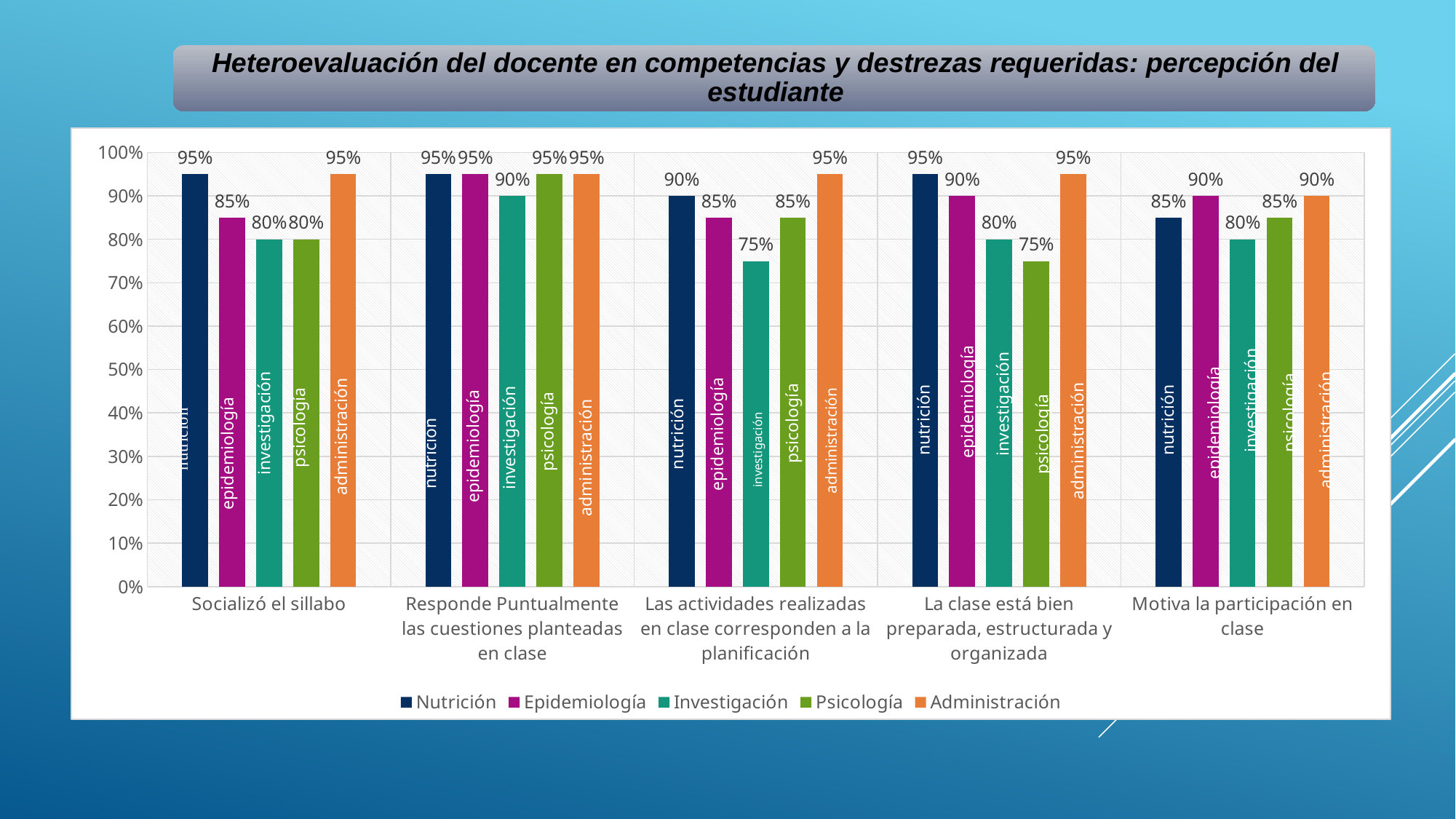
What is the value for Nutrición in the 'Socializó el sillabo' category? 95% What kind of chart is shown on the slide? Bar chart What is the value for Administración in the 'Motiva la participación en clase' category? 90% What is the value for Investigación in the 'Las actividades realizadas en clase corresponden a la planificación' category? 75% What is the difference between Nutrición and Psicología in the 'La clase está bien preparada, estructurada y organizada' category? 20% Which series has the highest value in the 'Las actividades realizadas en clase corresponden a la planificación' category? Administración Which series has the lowest value in the 'Socializó el sillabo' category? Investigación and Psicología (80%) What is the value for Psicología in the 'La clase está bien preparada, estructurada y organizada' category? 75% In the 'Motiva la participación en clase' category, which is larger: Epidemiología or Nutrición? Epidemiología Which series is shown in orange in the legend? Administración How many series does the legend list? 5 How many categories are shown on the x axis? 5